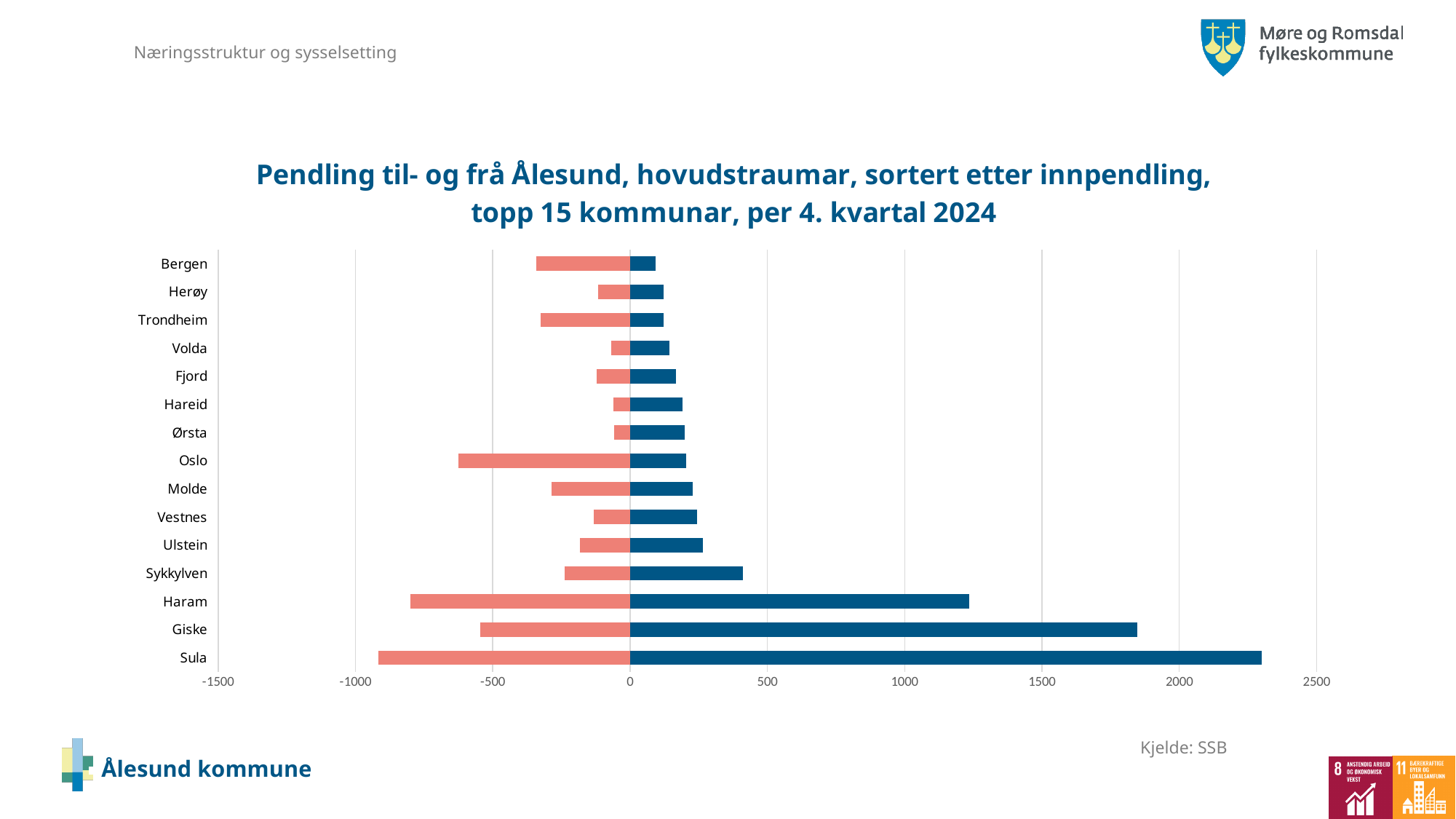
Which has the larger blue bar, Haram or Giske? Giske What kind of chart is shown on the slide? bar chart Is the red bar value for Sula greater or less than -1000? greater Is the blue bar value for Sula greater or less than 2000? greater Is the blue bar value for Giske greater or less than 1500? greater Which municipality has the longest blue (positive) bar? Sula Which has the larger blue bar, Sykkylven or Ulstein? Sykkylven Which municipality has the shortest blue (positive) bar? Bergen Which municipality has the longest red (negative) bar? Sula How many municipalities are listed on the chart? 15